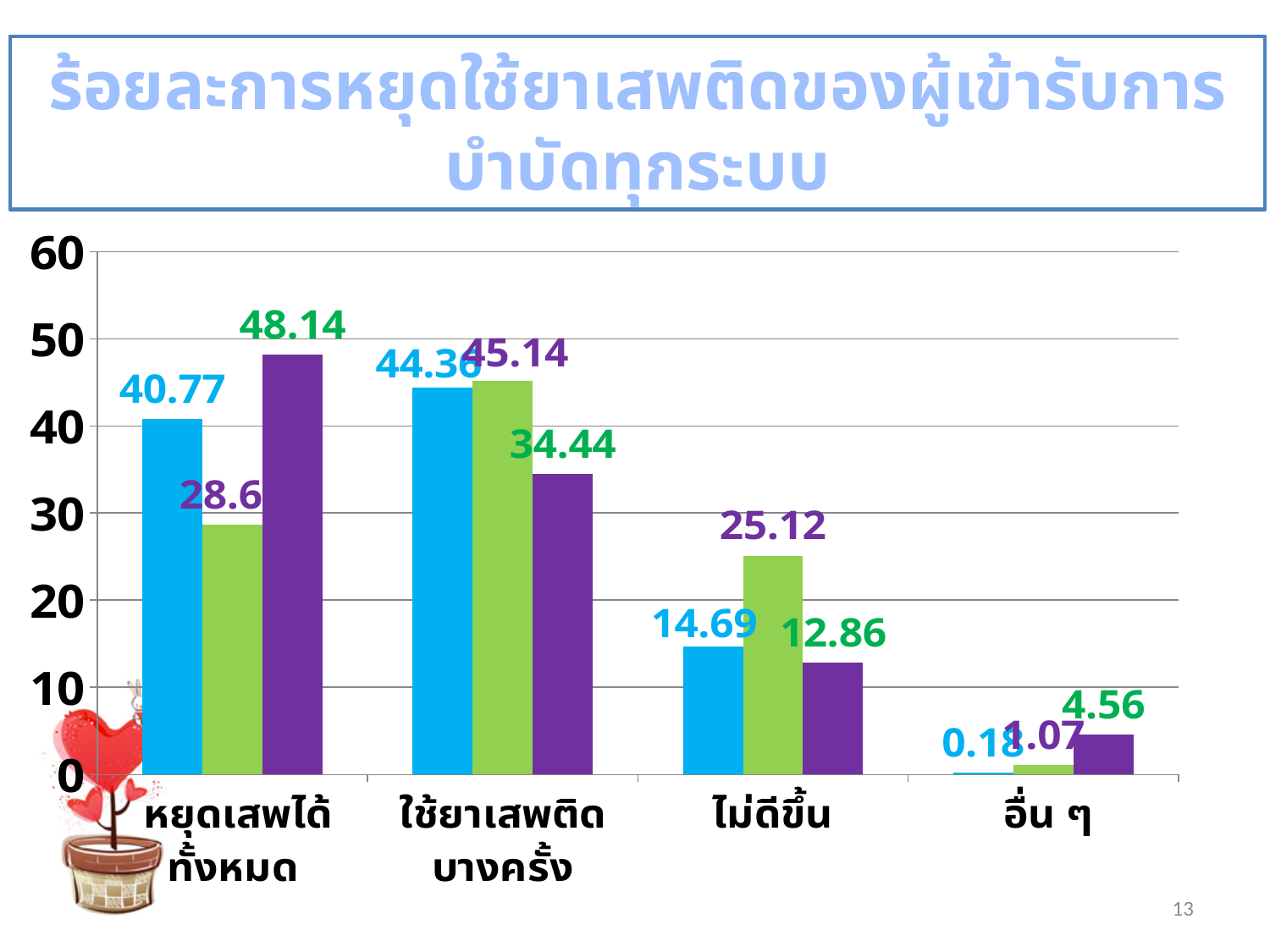
How many categories are shown on the x axis? 4 What kind of chart is shown on the slide? bar chart What is the title of the chart? ร้อยละการหยุดใช้ยาเสพติดของผู้เข้ารับการบำบัดทุกระบบ Is the value of the blue bar for ใช้ยาเสพติดบางครั้ง greater or less than 40? greater What is the value of the blue bar for หยุดเสพได้ทั้งหมด? 40.77 Which category has the highest purple bar? หยุดเสพได้ทั้งหมด What is the value of the purple bar for หยุดเสพได้ทั้งหมด? 48.14 What is the value of the purple bar for อื่น ๆ? 4.56 Which category has the lowest blue bar? อื่น ๆ Which is larger for ไม่ดีขึ้น, the blue bar or the purple bar? the blue bar What is the value of the green bar for ไม่ดีขึ้น? 25.12